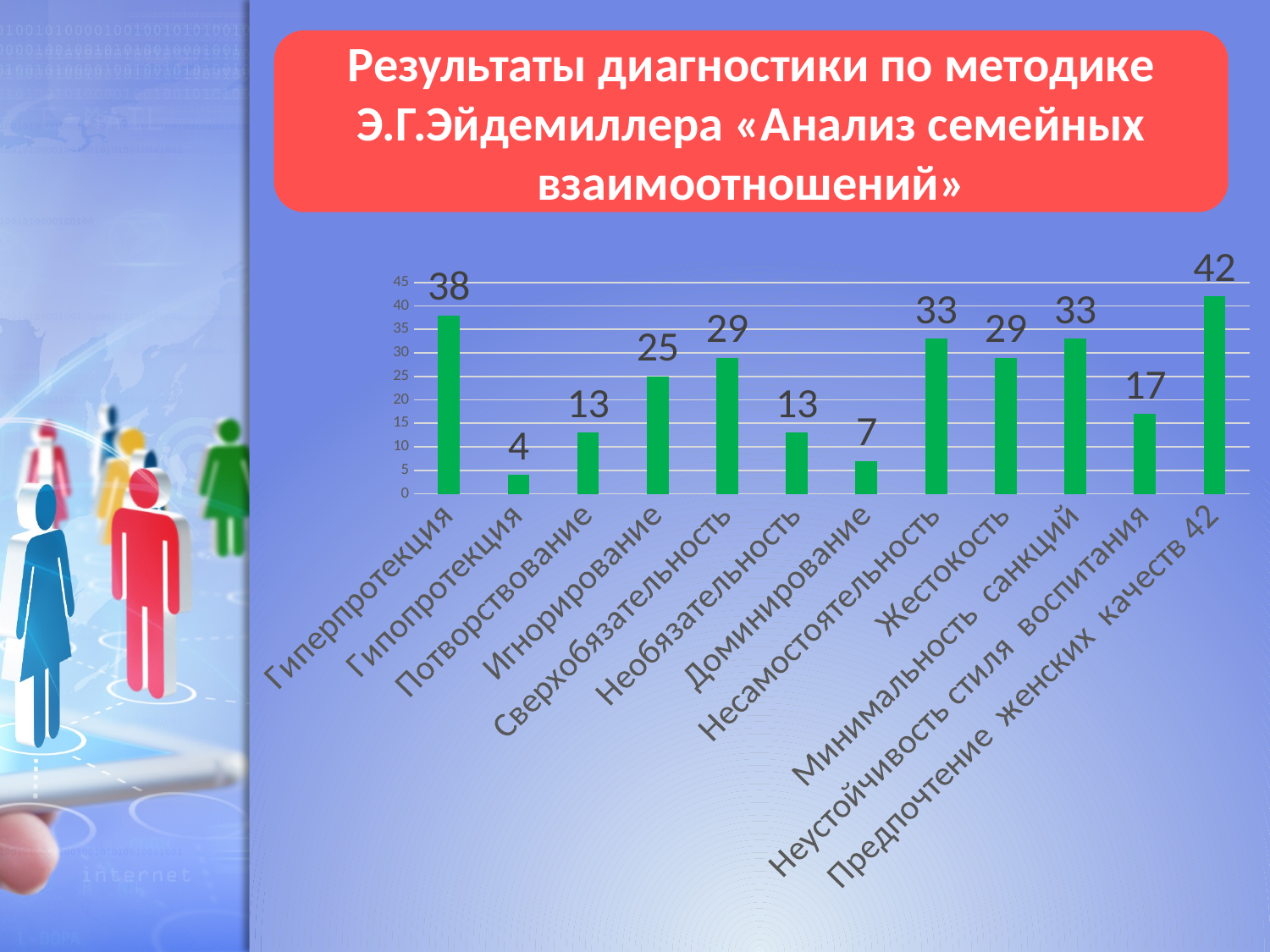
What colour are the bars in the chart? Green Which category has the lowest value? Гипопротекция What kind of chart is shown on the slide? Bar chart Which category has the highest value? Предпочтение женских качеств What is the value for Гиперпротекция? 38 Which is larger, the value for Сверхобязательность or the value for Необязательность? Сверхобязательность What is the difference between the values for Несамостоятельность and Жестокость? 4 What is the difference between the values for Гиперпротекция and Гипопротекция? 34 What is the value for Доминирование? 7 What is the value for Игнорирование? 25 What is the value for Неустойчивость стиля воспитания? 17 How many categories are shown in the chart? 12